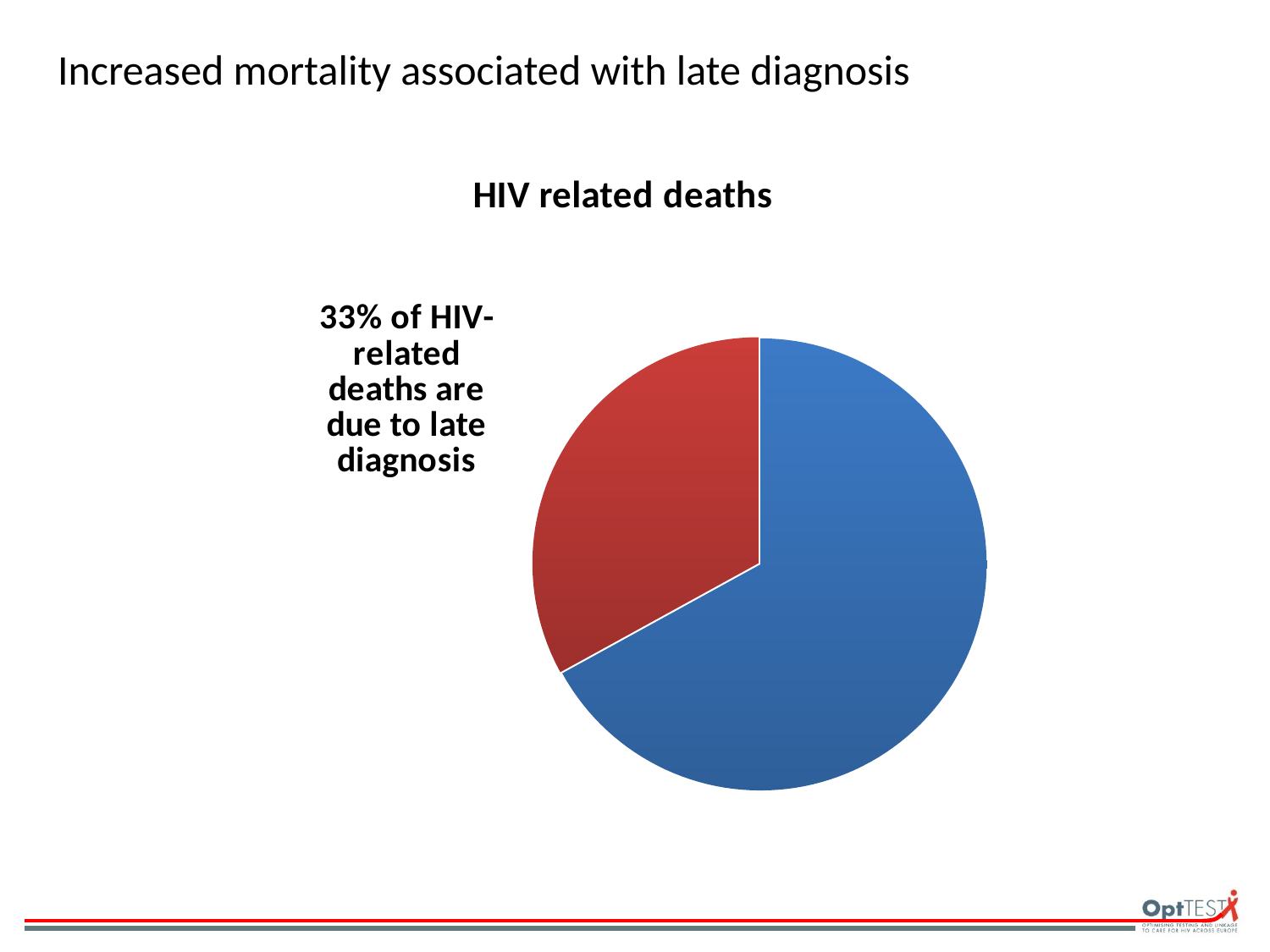
How many slices does the pie chart have? 2 What colour is the slice representing deaths due to late diagnosis? red What kind of chart is shown on the slide? pie chart What share of HIV-related deaths are due to late diagnosis according to the chart? 33% Which slice is larger, the red slice or the blue slice? the blue slice Which slice of the pie chart is the smallest? the red slice (deaths due to late diagnosis) What is the title of the chart? HIV related deaths